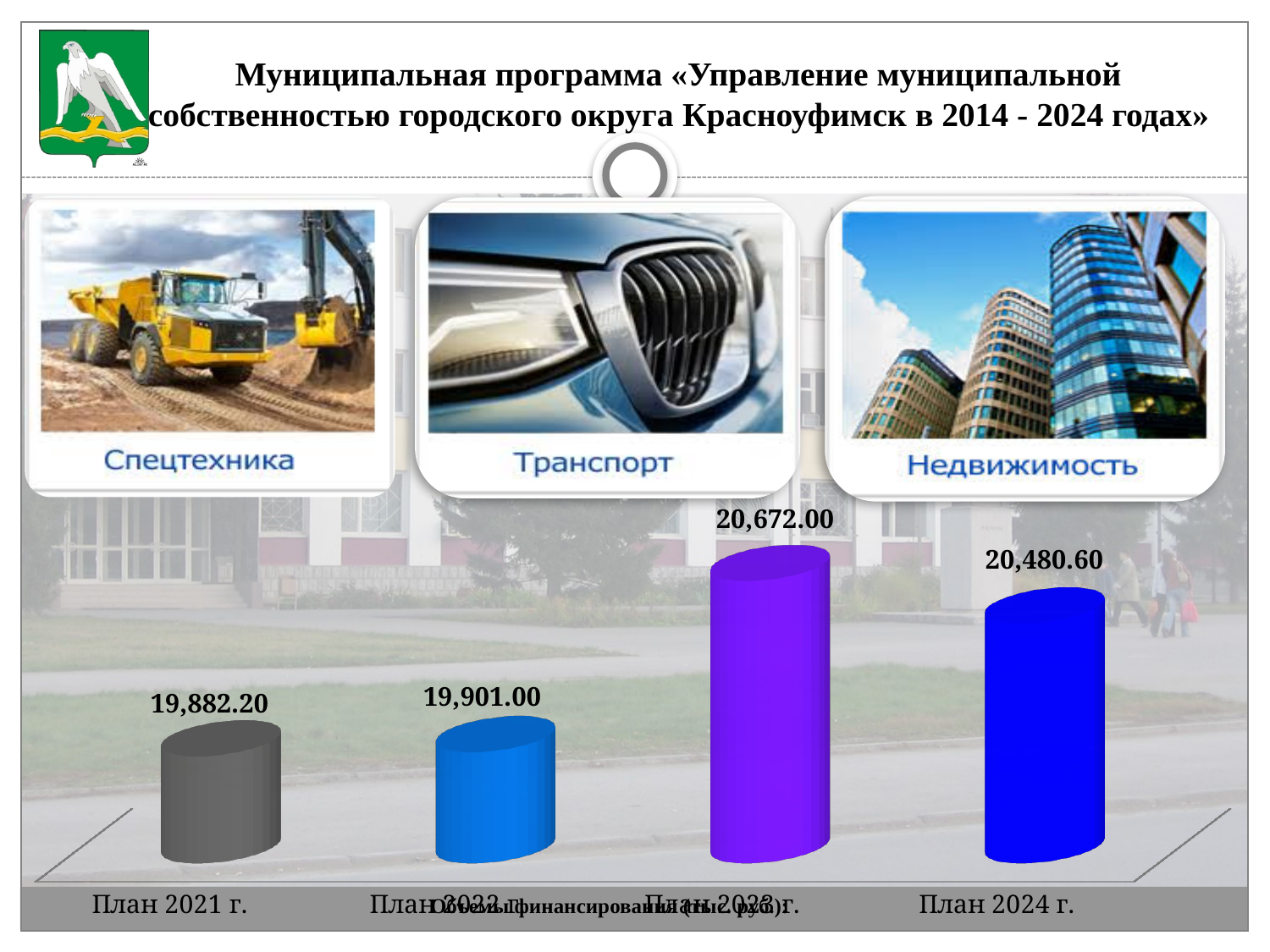
What is the difference between the values for План 2023 г. and План 2024 г.? 191.40 How many categories are plotted in the chart? 4 What kind of chart is shown on the slide? Bar chart What is the value for План 2024 г.? 20,480.60 What is the value for План 2023 г.? 20,672.00 What is the value for План 2022 г.? 19,901.00 Do the values rise or fall from План 2021 г. to План 2023 г.? Rise Which category has the lowest value? План 2021 г. What is the value for План 2021 г.? 19,882.20 Which category has the highest value? План 2023 г. Which is larger, the value for План 2024 г. or the value for План 2022 г.? План 2024 г. What is the difference between the values for План 2022 г. and План 2021 г.? 18.80